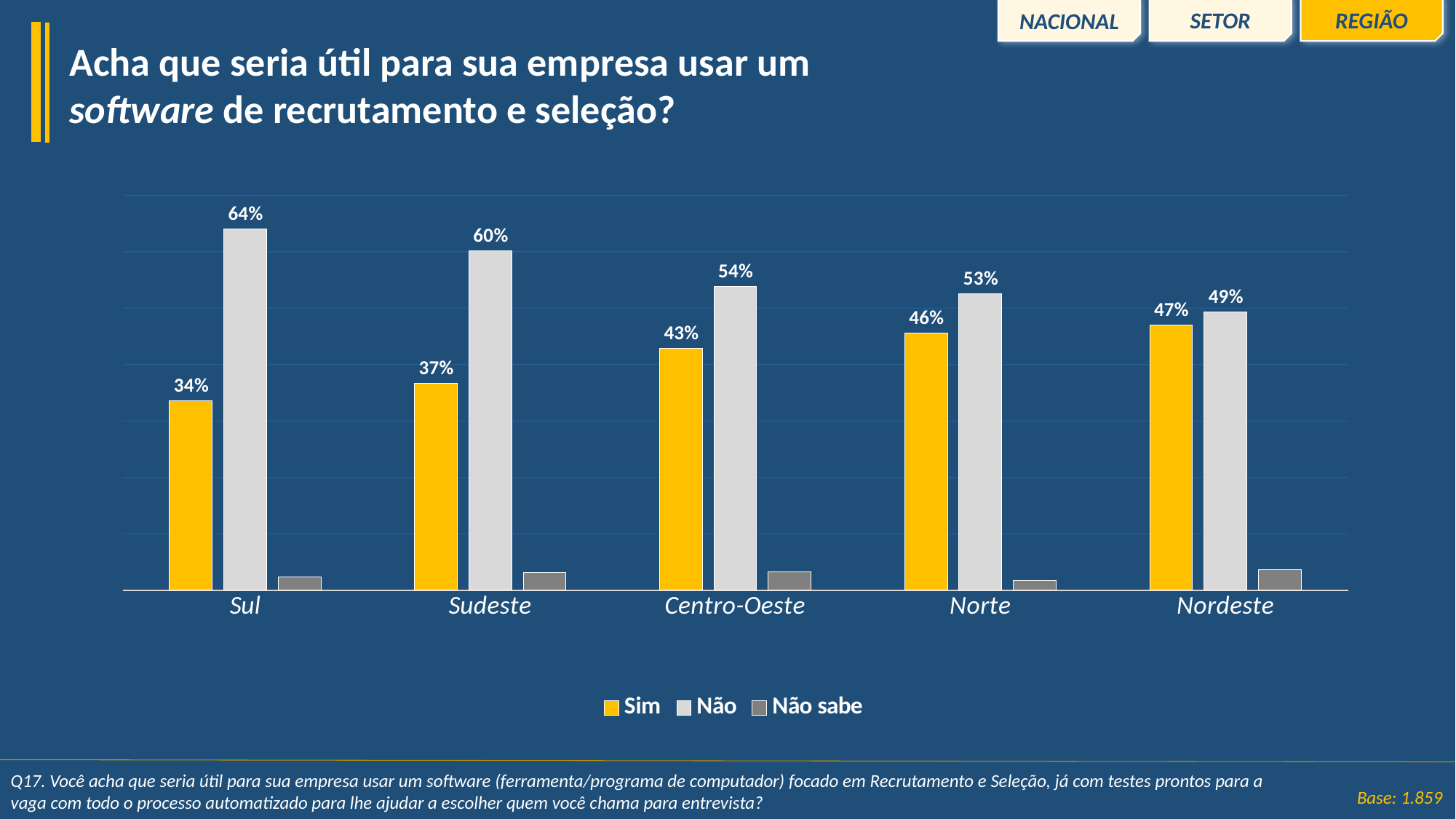
What is the difference between the "Não" and "Sim" values in the Centro-Oeste region? 11% What is the value for "Sim" in the Sul region? 34% Which region has the lowest value for "Sim"? Sul How many regions are shown on the x axis? 5 How many series does the legend list? 3 What is the value for "Não" in the Sudeste region? 60% Which colour represents the "Sim" series in the legend? Yellow What kind of chart is shown on the slide? Bar chart Which is larger in the Nordeste region: the "Sim" value or the "Não" value? Não What is the value for "Não" in the Norte region? 53% What is the value for "Sim" in the Nordeste region? 47% Which region has the highest value for "Não"? Sul